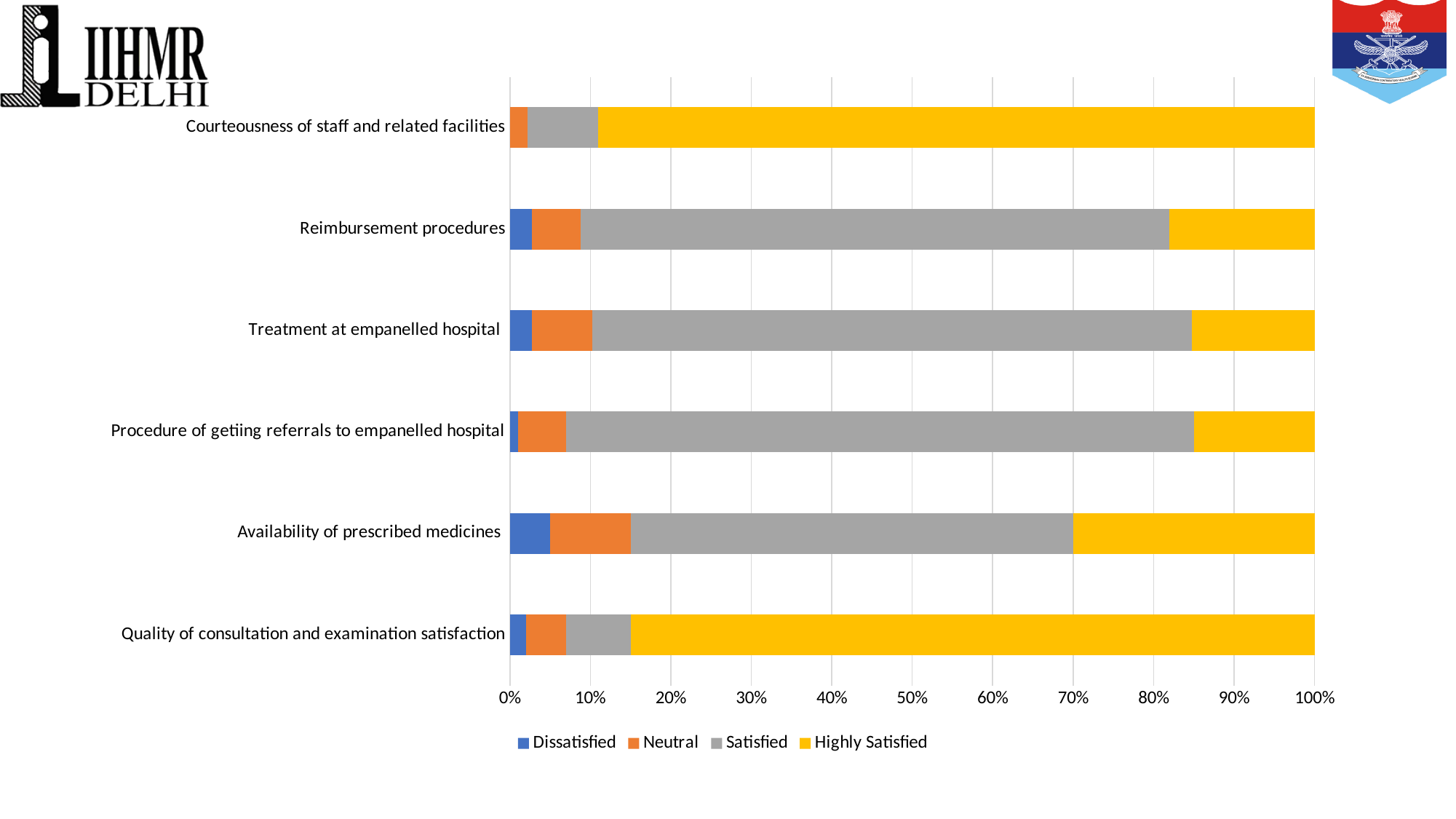
Which category has the largest Dissatisfied segment? Availability of prescribed medicines How many categories are plotted on the chart? 6 How many series does the legend list? 4 Which category has the largest Highly Satisfied segment? Courteousness of staff and related facilities Which colour represents the Highly Satisfied series? yellow What kind of chart is shown on the slide? bar chart What is the total of the stacked bar for Reimbursement procedures? 100% What are the four series named in the legend? Dissatisfied, Neutral, Satisfied, Highly Satisfied Is the Dissatisfied value for Availability of prescribed medicines greater or less than 10%? less Which has the larger Highly Satisfied segment: Availability of prescribed medicines or Reimbursement procedures? Availability of prescribed medicines Is the Highly Satisfied value for Courteousness of staff and related facilities greater or less than 80%? greater Is the Satisfied value for Availability of prescribed medicines greater or less than 50%? greater